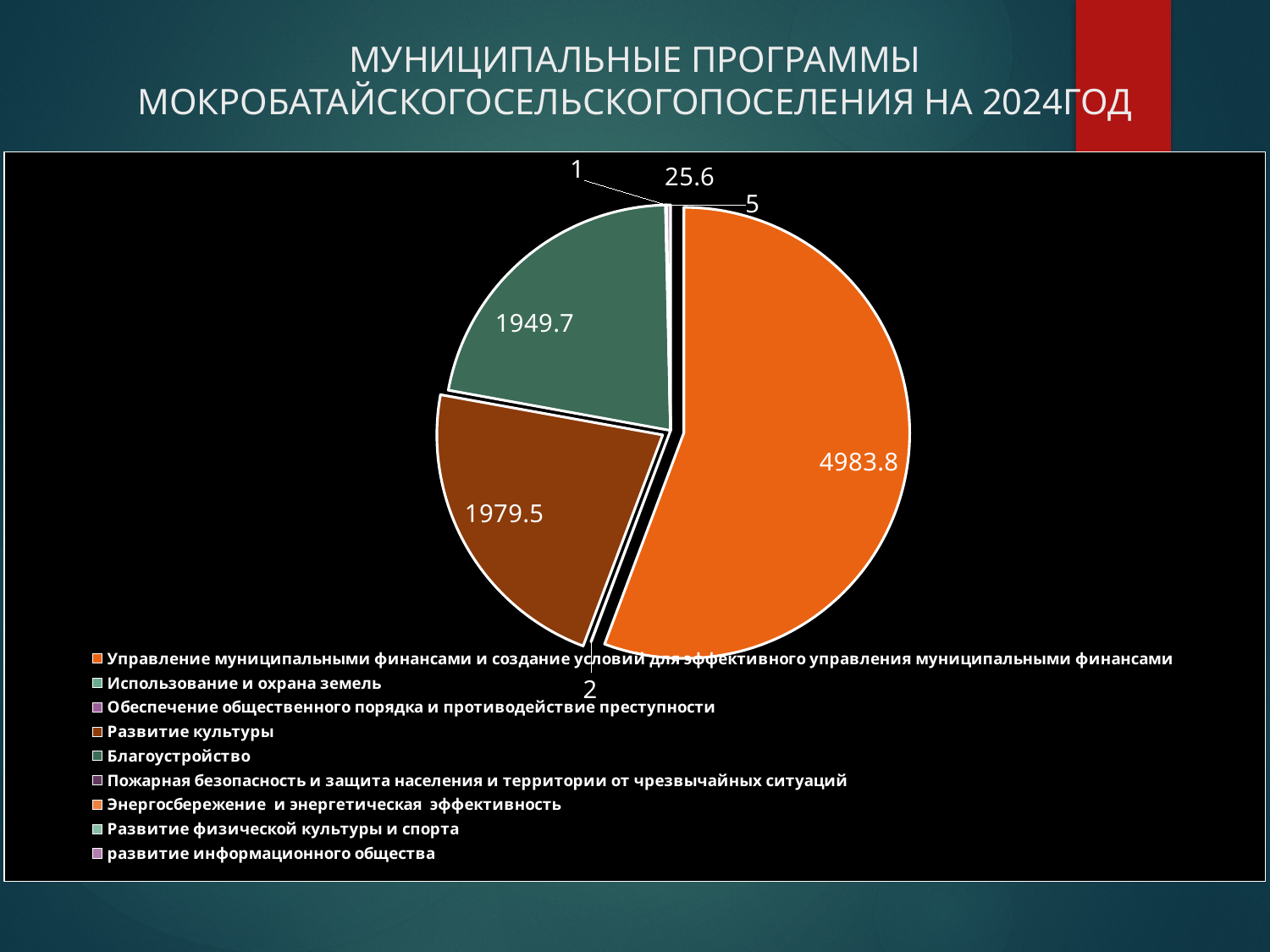
Is the value of the largest slice of the pie chart greater or less than 4000? greater What is the value shown on the brown slice at the lower left of the pie chart? 1979.5 What is the value shown on the green slice at the upper left of the pie chart? 1949.7 Which slice is larger, the brown slice labelled 1979.5 or the green slice labelled 1949.7? the brown slice (1979.5) Which legend entry is shown in orange, matching the largest slice? Управление муниципальными финансами и создание условий для эффективного управления муниципальными финансами What kind of chart is shown on the slide? pie chart What is the value of the largest slice of the pie chart? 4983.8 What is the difference between the brown slice (1979.5) and the green slice (1949.7)? 29.8 How many entries does the legend of the pie chart list? 9 What is the title of the slide containing the pie chart? МУНИЦИПАЛЬНЫЕ ПРОГРАММЫ МОКРОБАТАЙСКОГОСЕЛЬСКОГОПОСЕЛЕНИЯ НА 2024ГОД What is the difference between the largest slice (4983.8) and the brown slice (1979.5)? 3004.3 What is the value of the orange slice on the right side of the pie chart? 4983.8